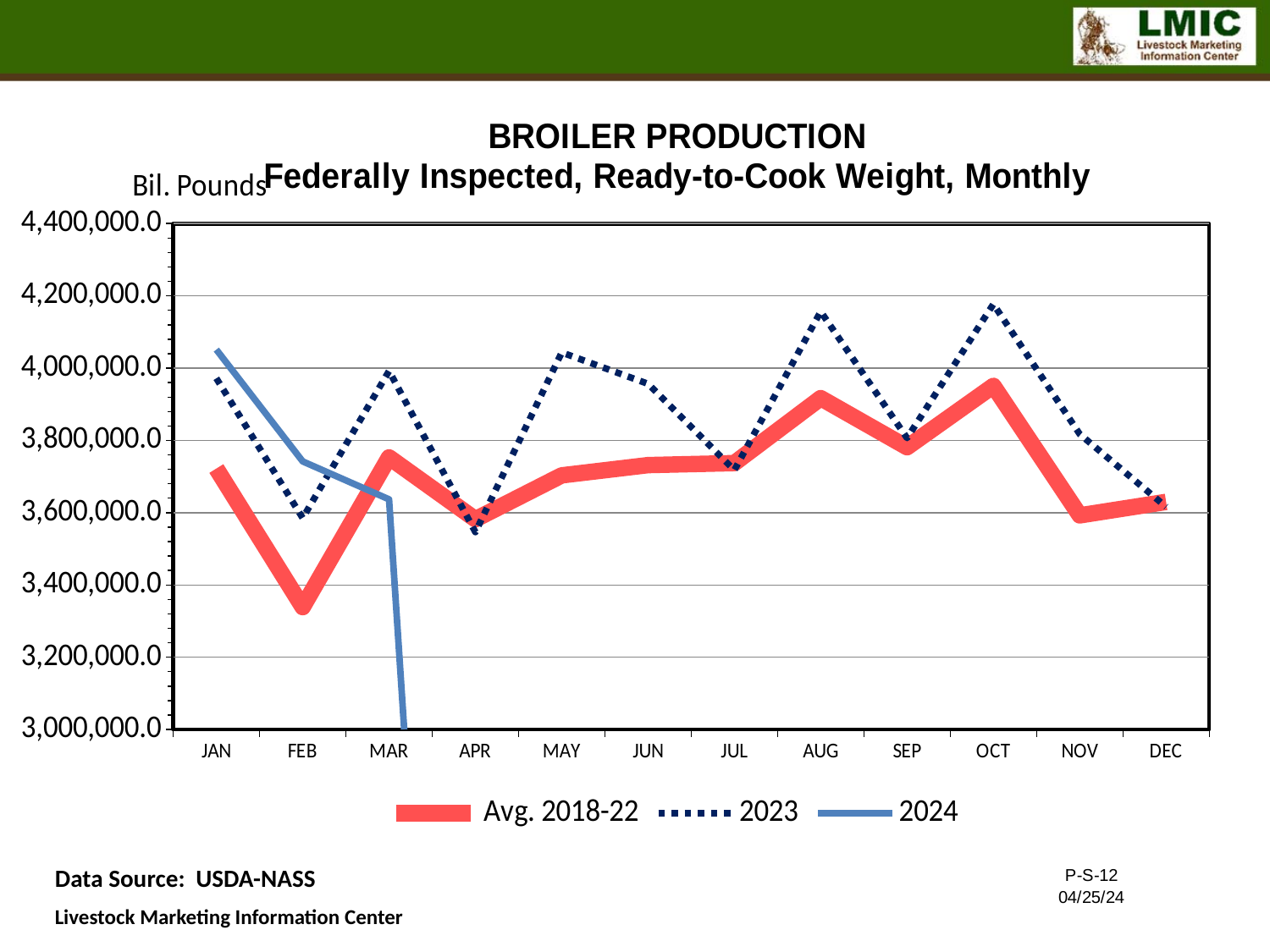
Is the value for 2024 in JAN greater or less than 4,000,000.0? greater Is the value for 2023 in AUG greater or less than 4,000,000.0? greater Is the value for Avg. 2018-22 in OCT greater or less than 4,000,000.0? less In which month is the Avg. 2018-22 series at its lowest? FEB What unit label is shown above the y axis? Bil. Pounds How many series does the legend list? 3 How many months are shown along the x axis? 12 Does the 2024 series rise or fall from JAN to MAR? fall What kind of chart is shown on the slide? line chart In FEB, which series has the larger value, 2023 or Avg. 2018-22? 2023 In JAN, which series has the larger value, 2024 or Avg. 2018-22? 2024